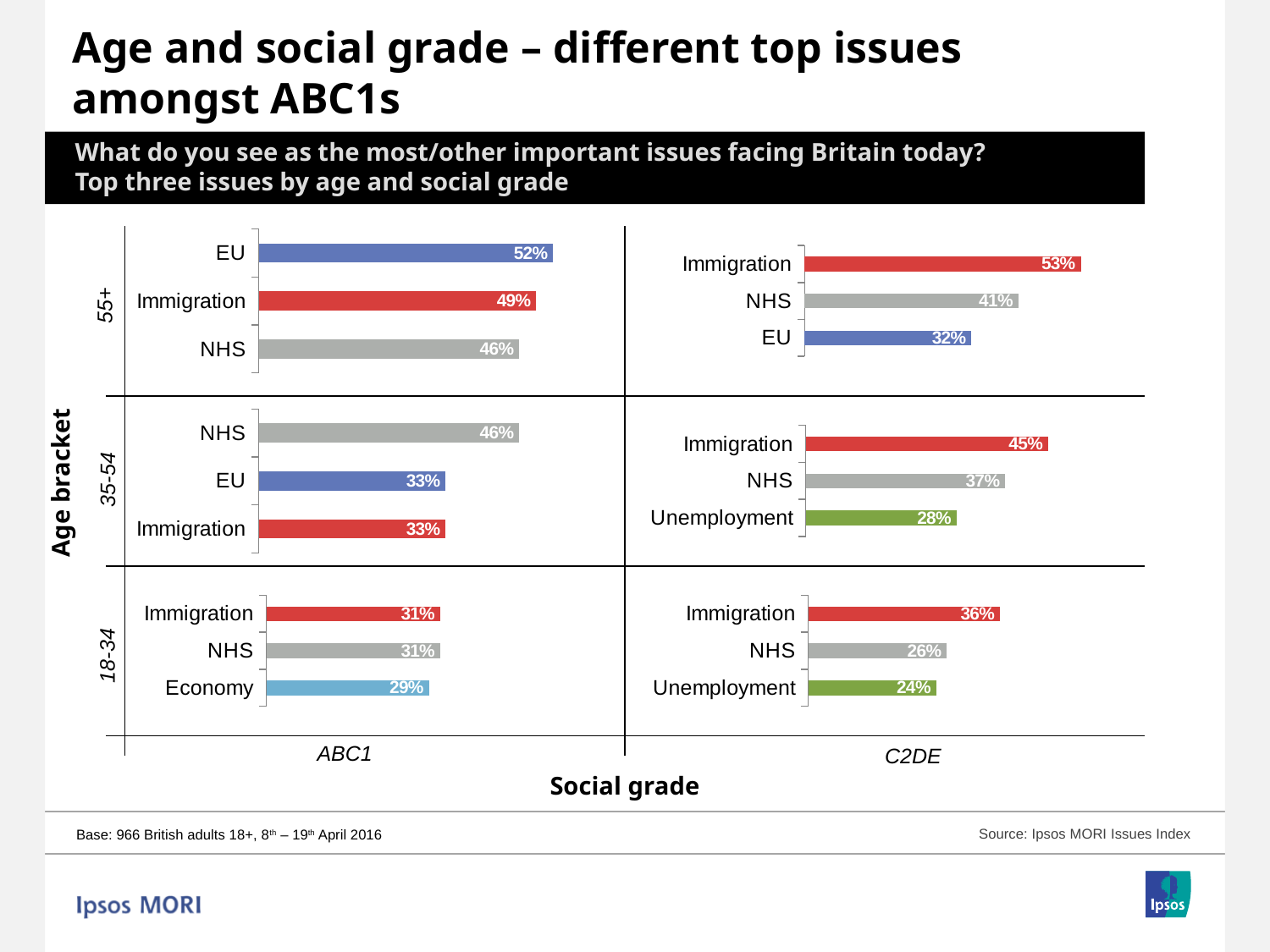
How many issues are shown in the chart for ABC1 aged 18-34? 3 In the chart for ABC1 aged 55+, what is the value for EU? 52% In the chart for C2DE aged 18-34, what is the difference between Immigration and NHS? 10% In the chart for C2DE aged 35-54, what is the value for Immigration? 45% What type of chart is used in each panel of the slide? Bar chart In the chart for ABC1 aged 55+, which is larger, Immigration or NHS? Immigration In the chart for ABC1 aged 18-34, what is the value for Economy? 29% In the chart for C2DE aged 55+, what is the difference between Immigration and EU? 21% Which issue appears in the chart for C2DE aged 18-34 but not in the chart for ABC1 aged 18-34? Unemployment In the chart for C2DE aged 55+, what is the value for NHS? 41% In the chart for C2DE aged 35-54, which issue has the lowest value? Unemployment In the chart for ABC1 aged 35-54, which issue has the highest value? NHS